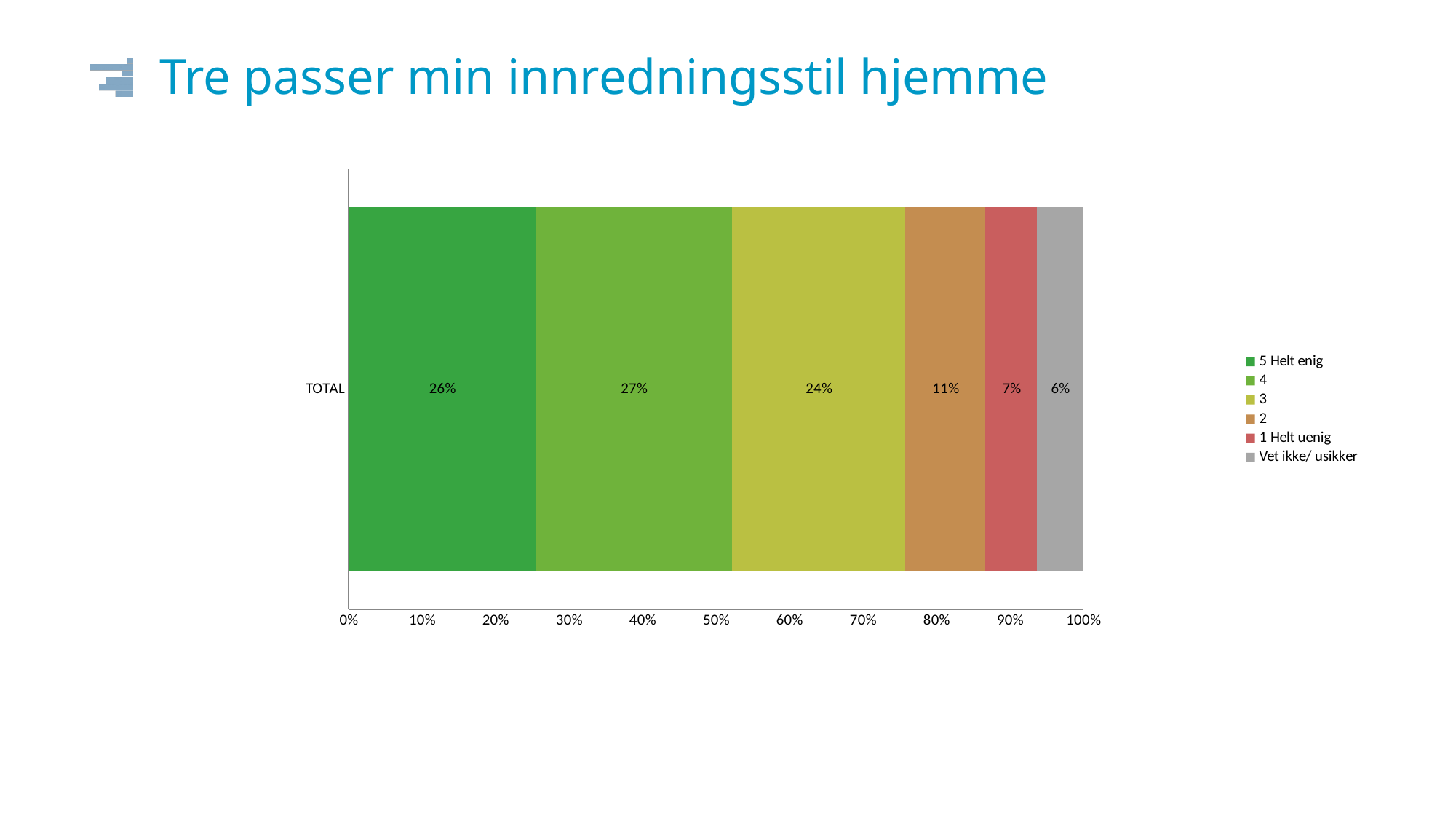
What kind of chart is shown on the slide? Stacked bar chart What is the value for "1 Helt uenig" in the TOTAL bar? 7% How many series does the legend list? 6 Which response category has the largest share in the TOTAL bar? 4 Which response category has the smallest share in the TOTAL bar? Vet ikke/ usikker What is the difference between the "3" segment and the "2" segment in the TOTAL bar? 13% What percentage of respondents answered "5 Helt enig" for TOTAL? 26% What is the combined share of "5 Helt enig" and "4" in the TOTAL bar? 53% Which is larger in the TOTAL bar: "5 Helt enig" or "3"? 5 Helt enig What is the value for the "4" segment in the TOTAL bar? 27% What share of the TOTAL bar is "Vet ikke/ usikker"? 6% What is the title of the slide? Tre passer min innredningsstil hjemme